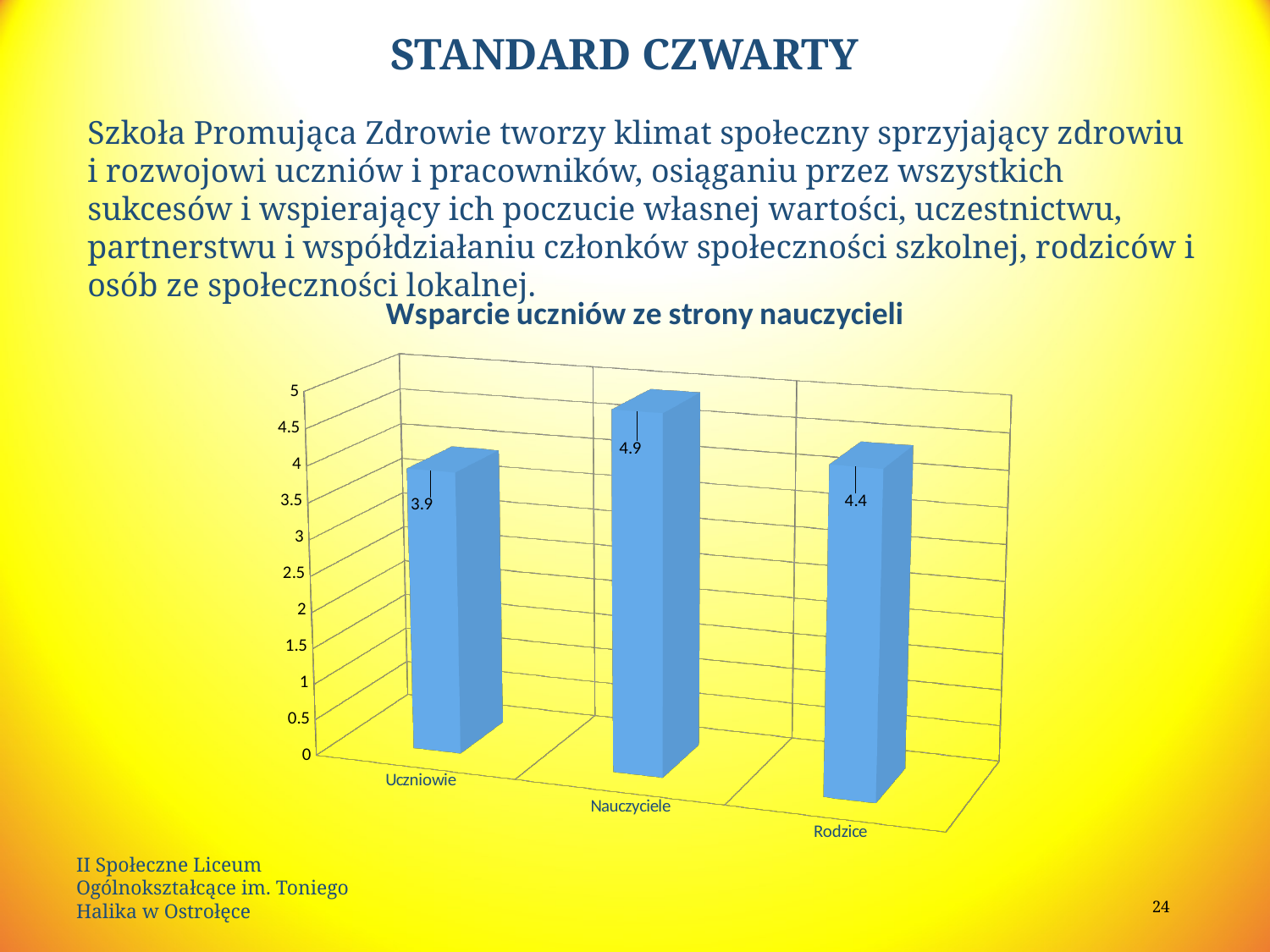
Is the value for Nauczyciele greater or less than 4.5? greater What is the value for Rodzice? 4.4 Which category has the lowest value? Uczniowie What is the value for Nauczyciele? 4.9 Which is larger, the value for Rodzice or the value for Uczniowie? Rodzice What is the value for Uczniowie? 3.9 What kind of chart is shown on the slide? bar chart What is the difference between the values for Nauczyciele and Uczniowie? 1 What is the difference between the values for Rodzice and Uczniowie? 0.5 Which category has the highest value? Nauczyciele How many categories are shown in the chart? 3 What is the title of the chart? Wsparcie uczniów ze strony nauczycieli